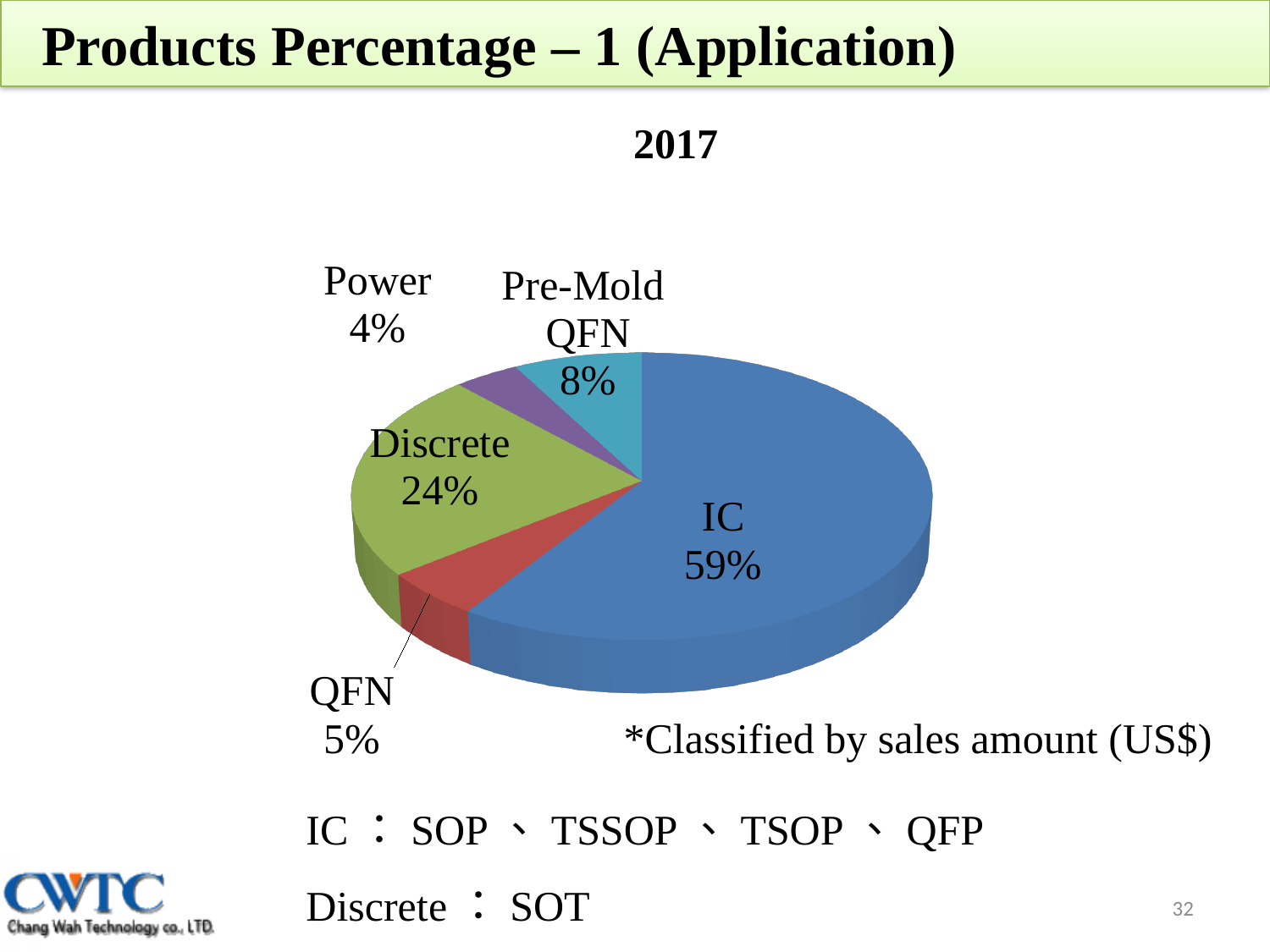
Which category has the smallest share of the pie? Power What percentage of the pie does Power account for? 4% What kind of chart is shown on the slide? pie chart What is the difference in percentage points between IC and Discrete? 35 What percentage of the pie does Pre-Mold QFN account for? 8% How many slices does the pie chart have? 5 Which category has the largest share of the pie? IC What percentage of the pie does IC account for? 59% What percentage of the pie does Discrete account for? 24% Which is larger, the share for Pre-Mold QFN or the share for QFN? Pre-Mold QFN What percentage of the pie does QFN account for? 5% What is the chart's title? 2017